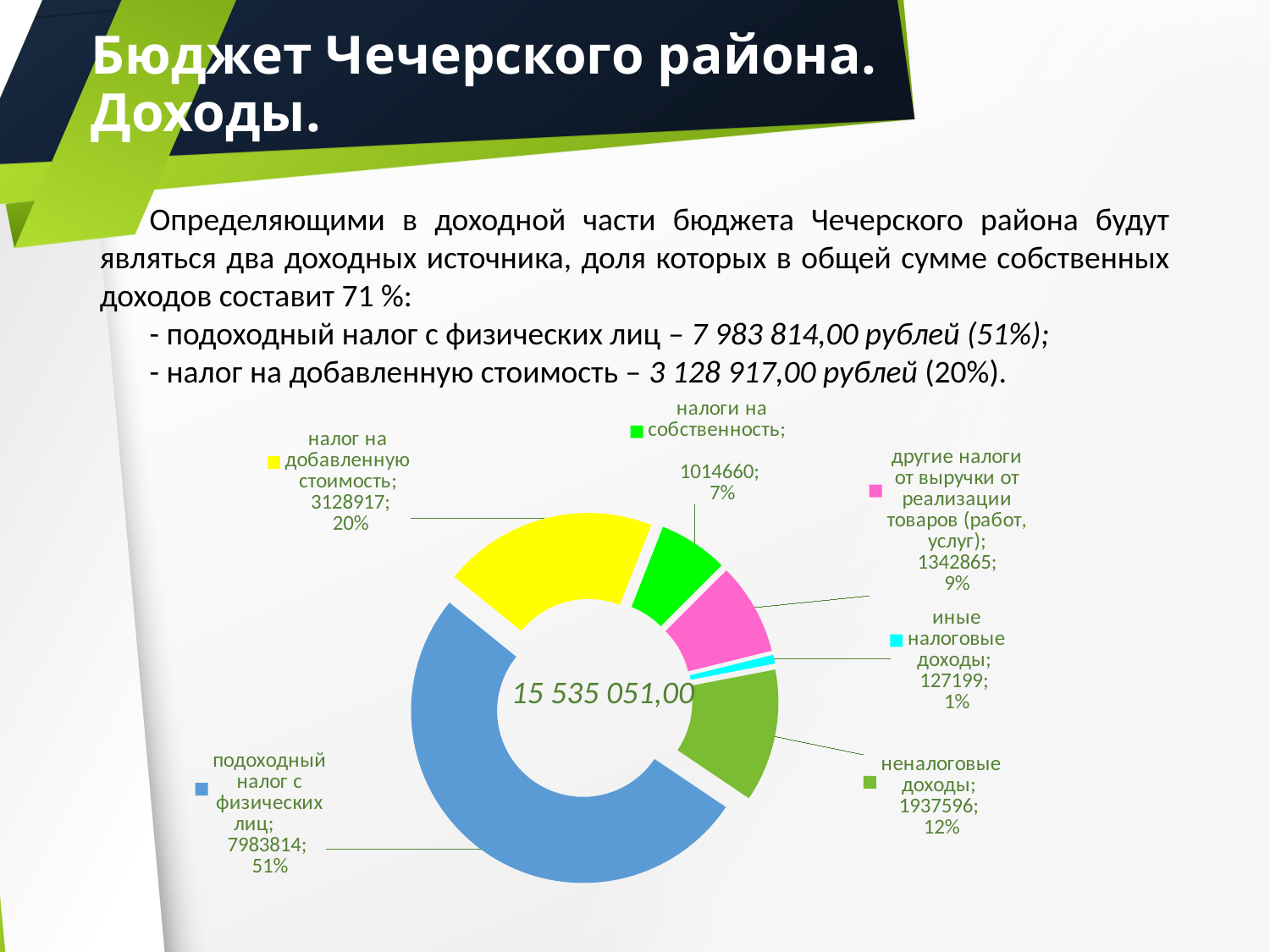
What value is shown for подоходный налог с физических лиц? 7983814 What percentage is shown for налоги на собственность? 7% Which is larger: неналоговые доходы or другие налоги от выручки от реализации товаров (работ, услуг)? неналоговые доходы What total value is printed in the centre of the doughnut chart? 15 535 051,00 Which category has the smallest slice? иные налоговые доходы What kind of chart is shown on the slide? Doughnut (pie) chart How many categories (slices) does the chart show? 6 What share of the chart does налог на добавленную стоимость represent? 20% What is the difference between the values for подоходный налог с физических лиц and налог на добавленную стоимость? 4854897 What value is shown for неналоговые доходы? 1937596 Which category has the largest slice? подоходный налог с физических лиц What colour is the slice for иные налоговые доходы? Cyan (light blue)